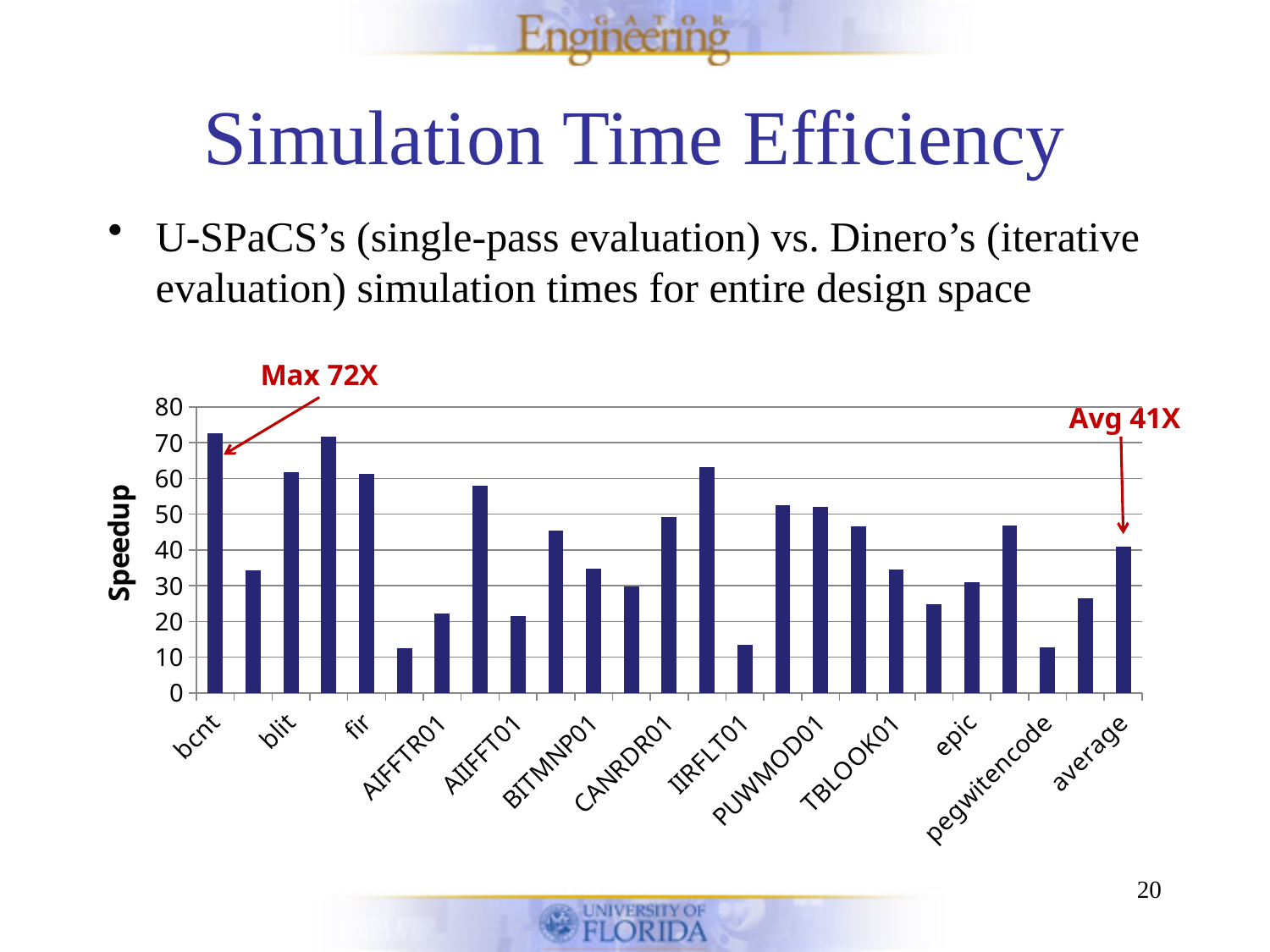
What maximum speedup does the annotation on the chart state? 72X What kind of chart is shown on the slide? bar chart Which benchmark has the highest speedup? bcnt What is the label of the y axis? Speedup Is the speedup for blit greater or less than 50? greater Which has the larger speedup, AIFFTR01 or BITMNP01? BITMNP01 Is the speedup for bcnt greater or less than 70? greater Is the speedup for epic greater or less than 40? less What average speedup does the annotation on the chart state? 41X Which has the larger speedup, bcnt or blit? bcnt